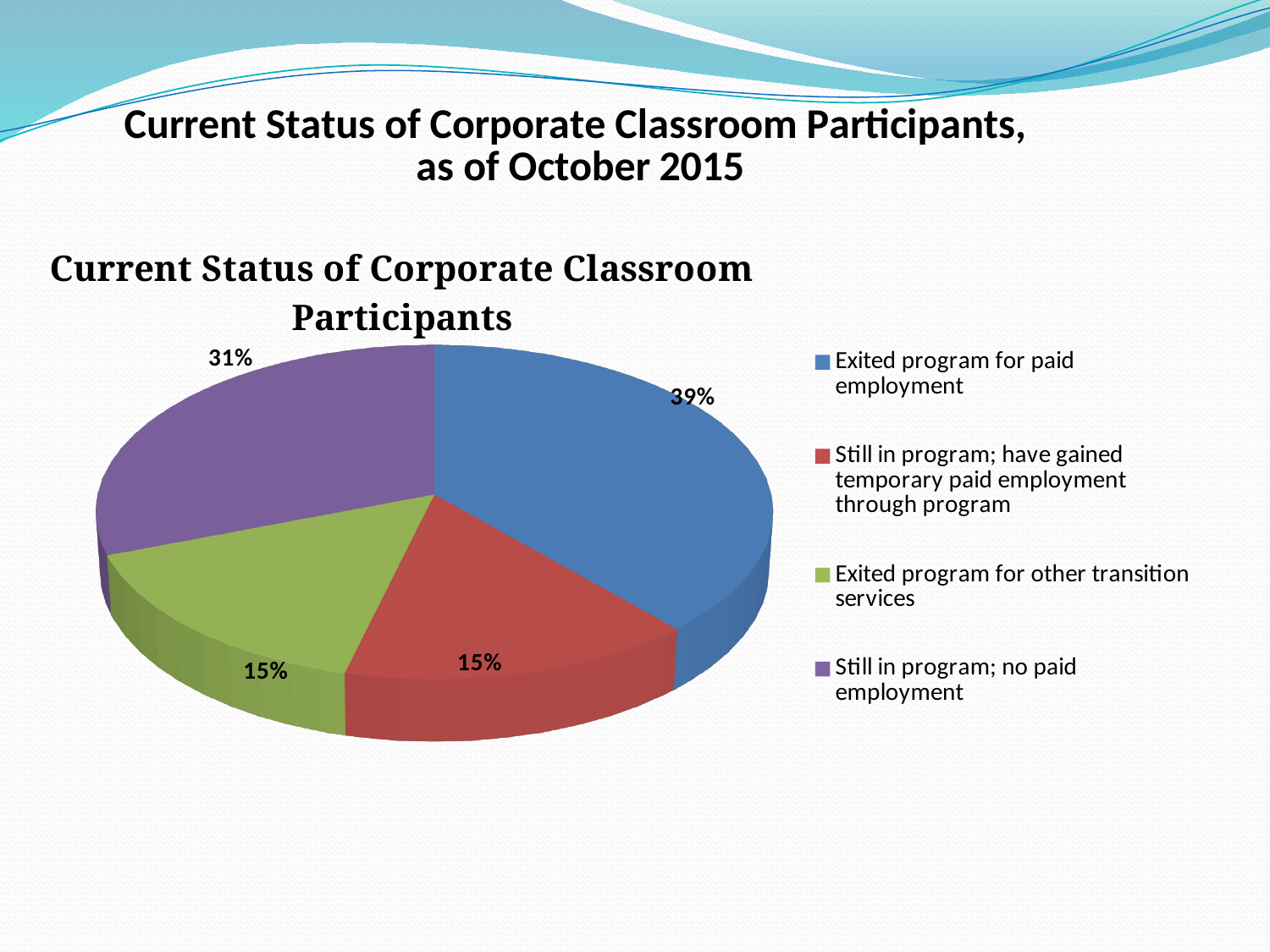
What share of participants exited the program for other transition services? 15% Which colour represents 'Exited program for other transition services' in the legend? Green What kind of chart is shown on the slide? Pie chart How many categories does the pie chart show? 4 Which is larger: the share for 'Still in program; no paid employment' or the share for 'Exited program for other transition services'? Still in program; no paid employment What share of participants exited the program for paid employment? 39% What share of participants are still in the program with no paid employment? 31% What share of participants are still in the program and have gained temporary paid employment through the program? 15% What is the title of the chart? Current Status of Corporate Classroom Participants What is the combined share of participants who are still in the program (both legend entries starting with 'Still in program')? 46% What is the difference in percentage points between 'Exited program for paid employment' and 'Still in program; no paid employment'? 8 percentage points Which category has the largest share of the pie? Exited program for paid employment